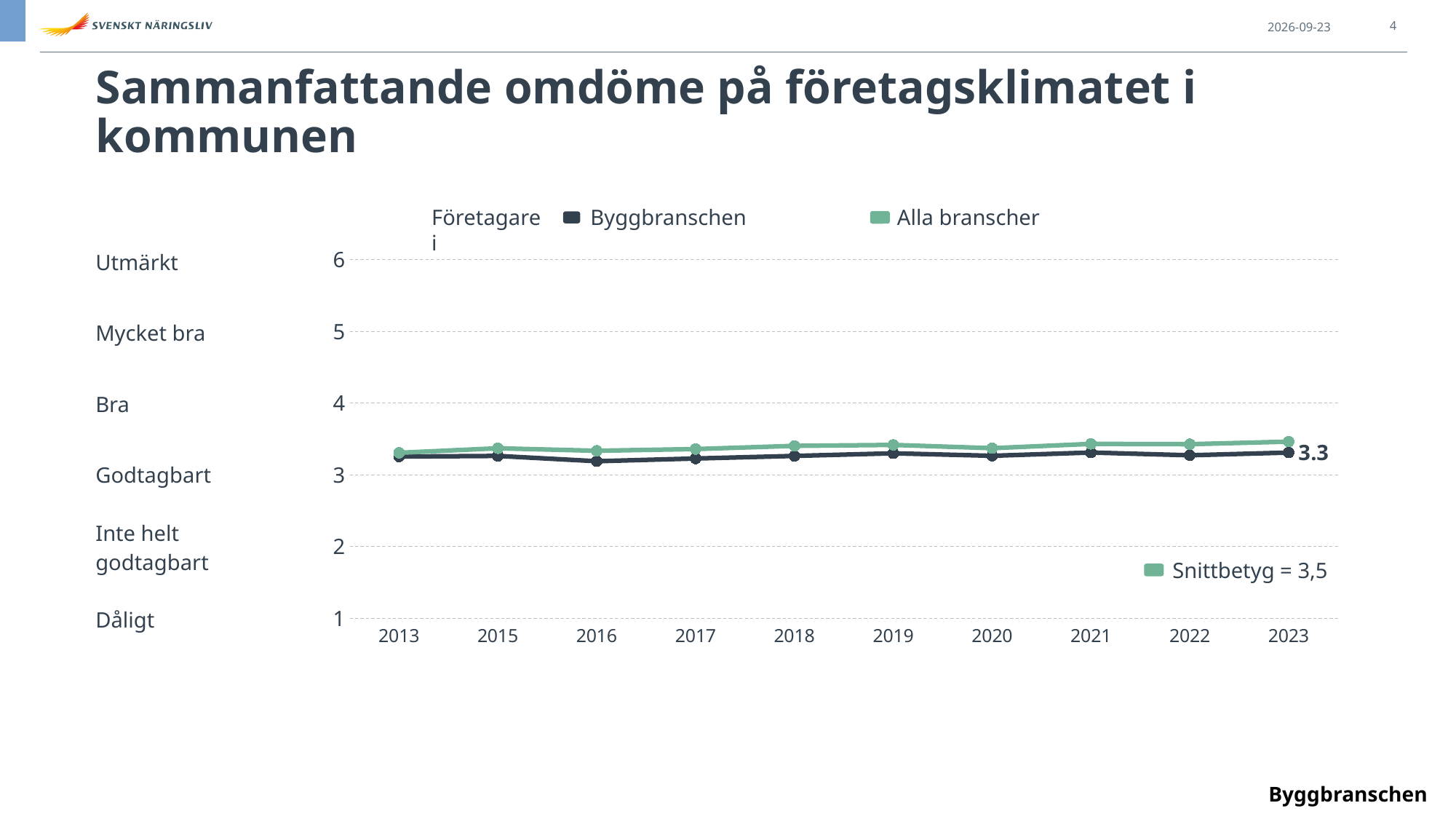
In 2016, which series has the lower value, Byggbranschen or Alla branscher? Byggbranschen What is the value for Byggbranschen in 2023? 3.3 What kind of chart is shown on the slide? line chart In 2023, which series has the higher value, Byggbranschen or Alla branscher? Alla branscher Which rating label corresponds to the value 6 on the y axis? Utmärkt Is the value for Alla branscher in 2023 greater or less than 3? greater How many data series does the legend list? 2 Is the value for Byggbranschen in 2016 greater or less than 4? less What is the first year shown on the x axis? 2013 How many years are plotted along the x axis? 10 Does the Alla branscher line rise or fall from 2013 to 2023? rise What is the Snittbetyg (average score) shown on the chart? 3,5